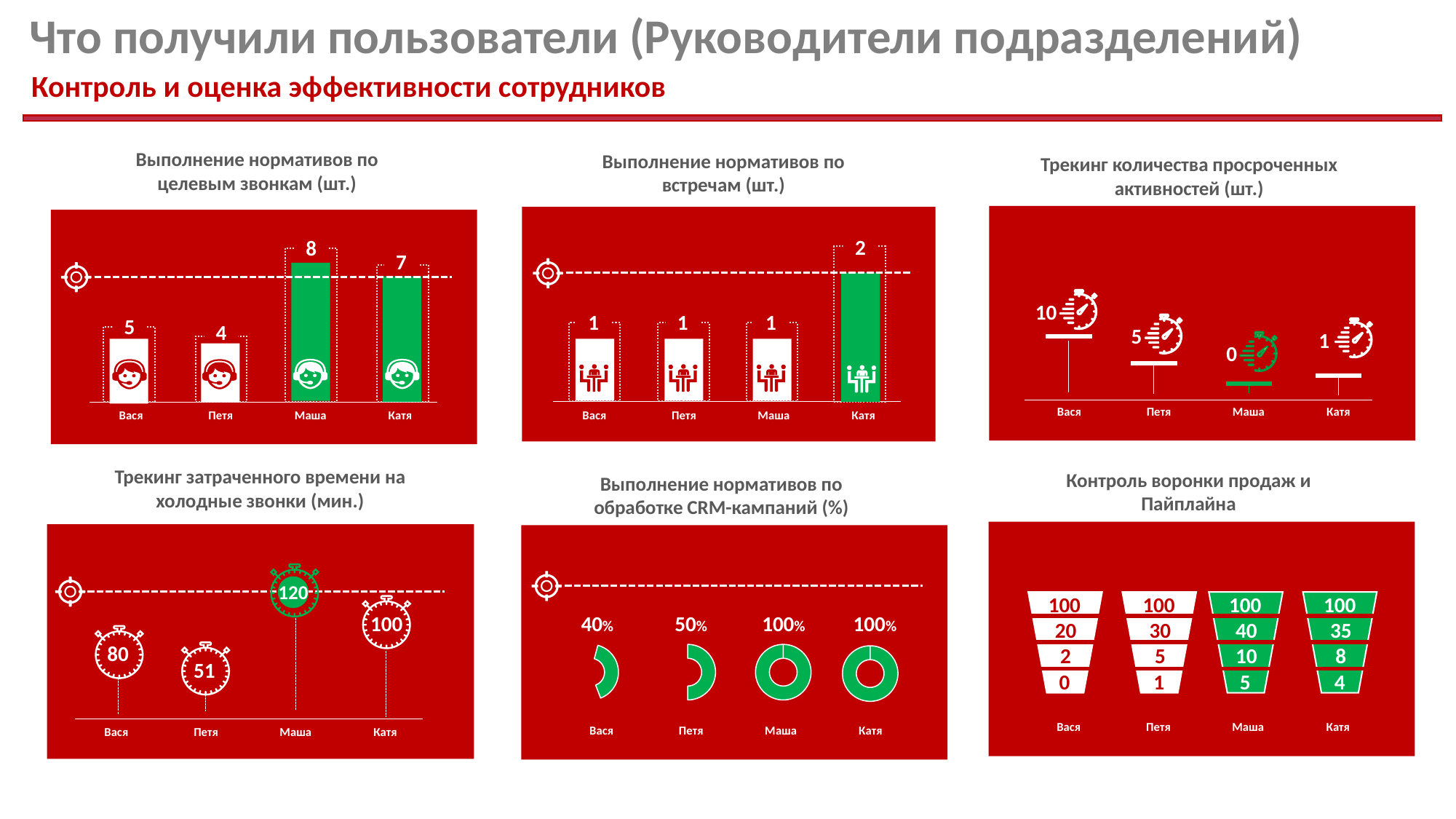
In the chart 'Трекинг количества просроченных активностей (шт.)', what is the value for Вася? 10 What kind of chart is 'Выполнение нормативов по целевым звонкам (шт.)'? bar chart In the chart 'Трекинг затраченного времени на холодные звонки (мин.)', what is the value for Петя? 51 How many people are shown in the chart 'Выполнение нормативов по встречам (шт.)'? 4 In the chart 'Контроль воронки продаж и Пайплайна', what is the bottom value of the funnel for Маша? 5 In the chart 'Трекинг количества просроченных активностей (шт.)', which person has the lowest value? Маша In the chart 'Выполнение нормативов по целевым звонкам (шт.)', what is the value for Маша? 8 In the chart 'Выполнение нормативов по целевым звонкам (шт.)', what is the difference between the values for Маша and Вася? 3 In the chart 'Трекинг затраченного времени на холодные звонки (мин.)', which is larger, the value for Вася or the value for Катя? Катя In the chart 'Выполнение нормативов по целевым звонкам (шт.)', which person has the lowest value? Петя In the chart 'Выполнение нормативов по встречам (шт.)', which person has the highest value? Катя In the chart 'Выполнение нормативов по обработке CRM-кампаний (%)', what is the value for Вася? 40%